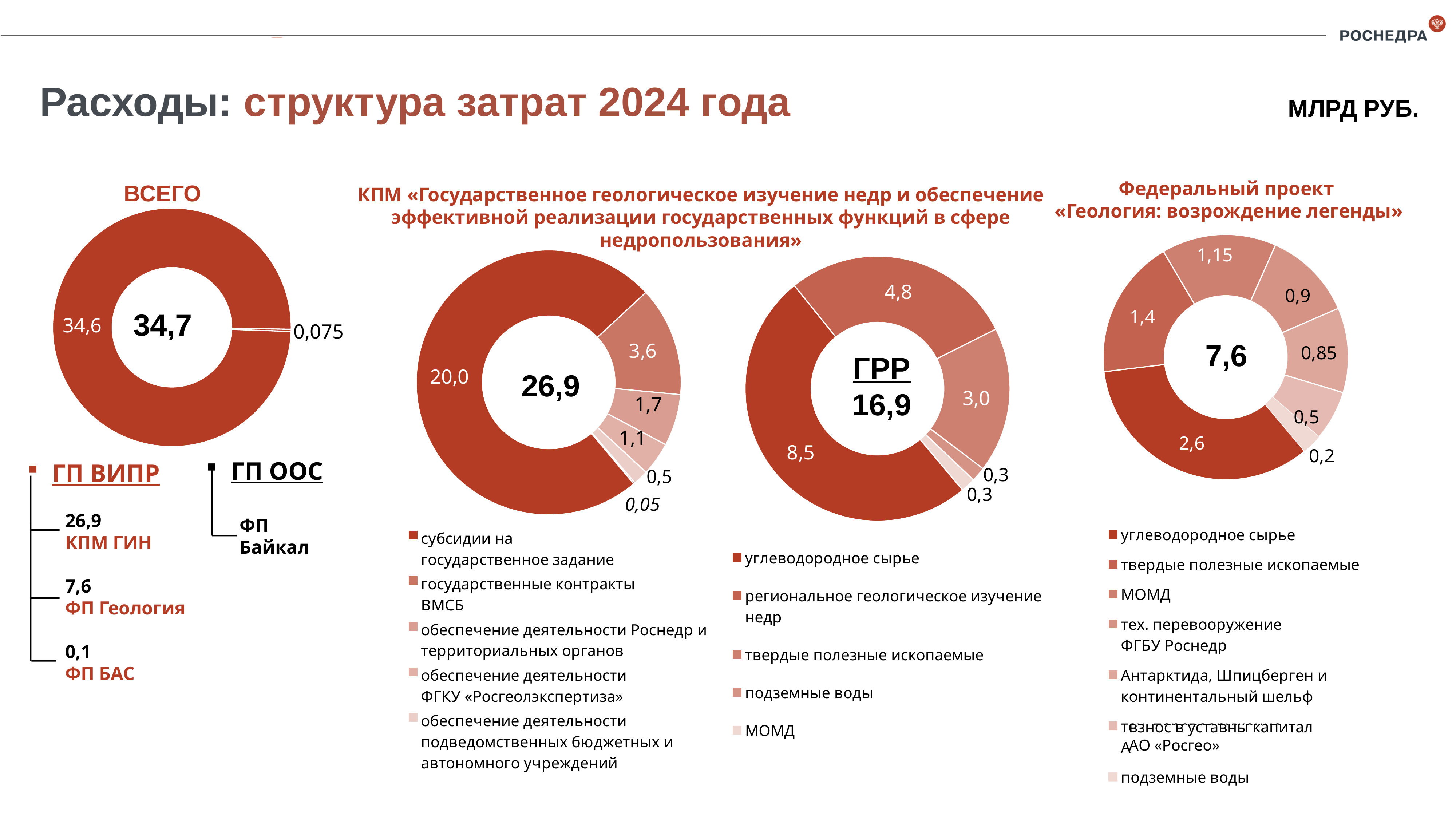
On the ГРР chart (third from left), what is the value for 'углеводородное сырье'? 8,5 On the 'Федеральный проект «Геология: возрождение легенды»' chart, how many slices does the donut have? 7 On the 'ВСЕГО' chart, what is the value of the large slice? 34,6 On the 'ВСЕГО' chart, what value is shown in the centre of the donut? 34,7 On the 'ВСЕГО' chart, what is the value of the small slice? 0,075 On the ГРР chart (third from left), how many entries does the legend list? 5 On the КПМ chart (second from left), what is the value of the largest slice? 20,0 What type of chart is used for the 'ВСЕГО' chart? Donut (pie) chart On the 'Федеральный проект «Геология: возрождение легенды»' chart, what is the value of the smallest slice? 0,2 On the КПМ chart (second from left), what total is shown in the centre of the donut? 26,9 On the ГРР chart (third from left), what is the difference between the 'углеводородное сырье' slice (8,5) and the 'твердые полезные ископаемые' slice (3,0)? 5,5 On the КПМ chart (second from left), what is the value for 'государственные контракты ВМСБ'? 3,6